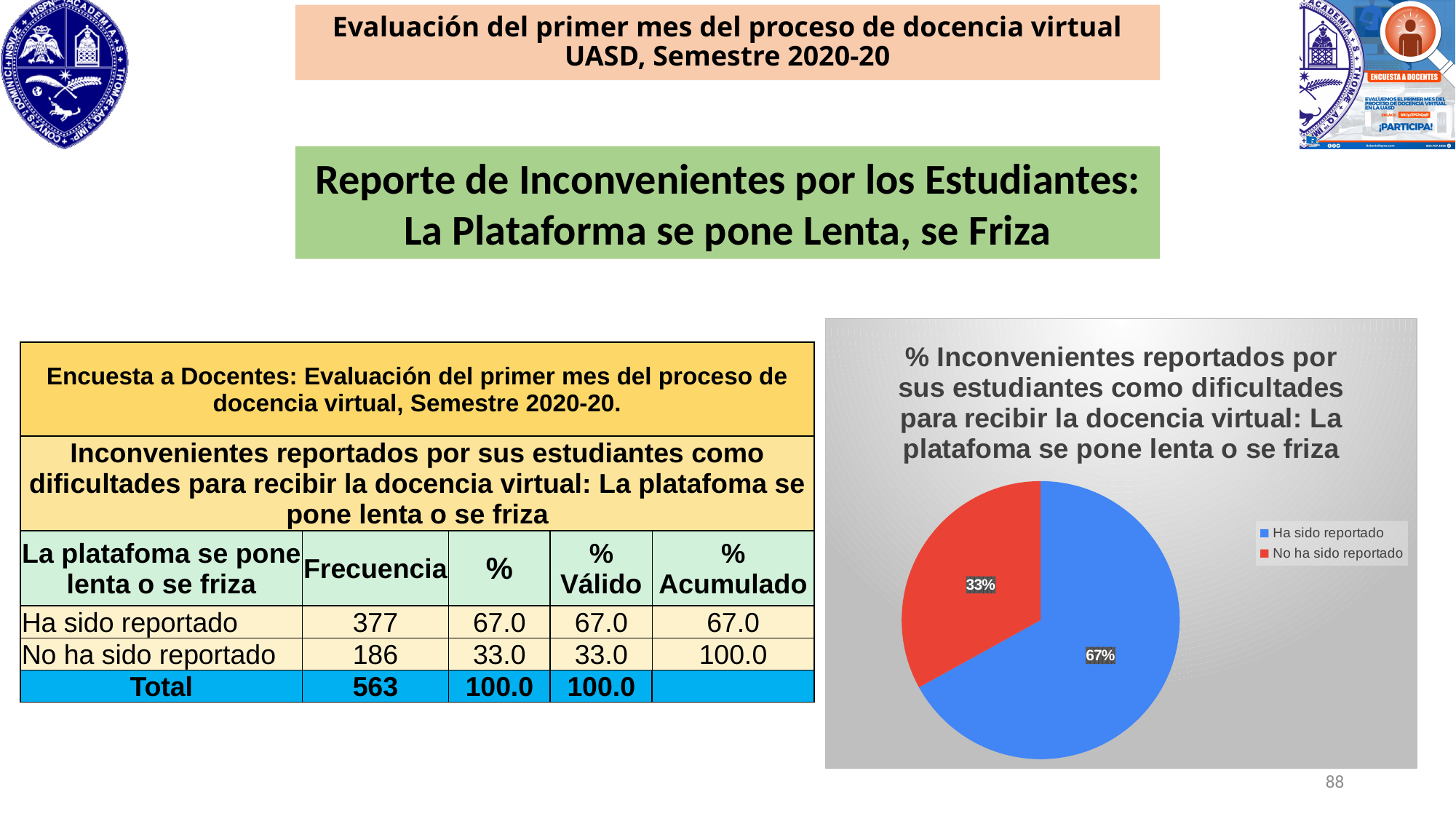
What percentage does the pie chart show for "Ha sido reportado"? 67% Which slice of the pie chart is the largest? Ha sido reportado Which slice of the pie chart is the smallest? No ha sido reportado What kind of chart is shown on the slide? pie chart What is the difference in percentage points between the "Ha sido reportado" and "No ha sido reportado" slices? 34 How many slices does the pie chart have? 2 What colour is the "No ha sido reportado" slice in the pie chart? red Which is larger in the pie chart, "Ha sido reportado" or "No ha sido reportado"? Ha sido reportado What percentage does the pie chart show for "No ha sido reportado"? 33% How many entries does the pie chart legend list? 2 What colour is the "Ha sido reportado" slice in the pie chart? blue